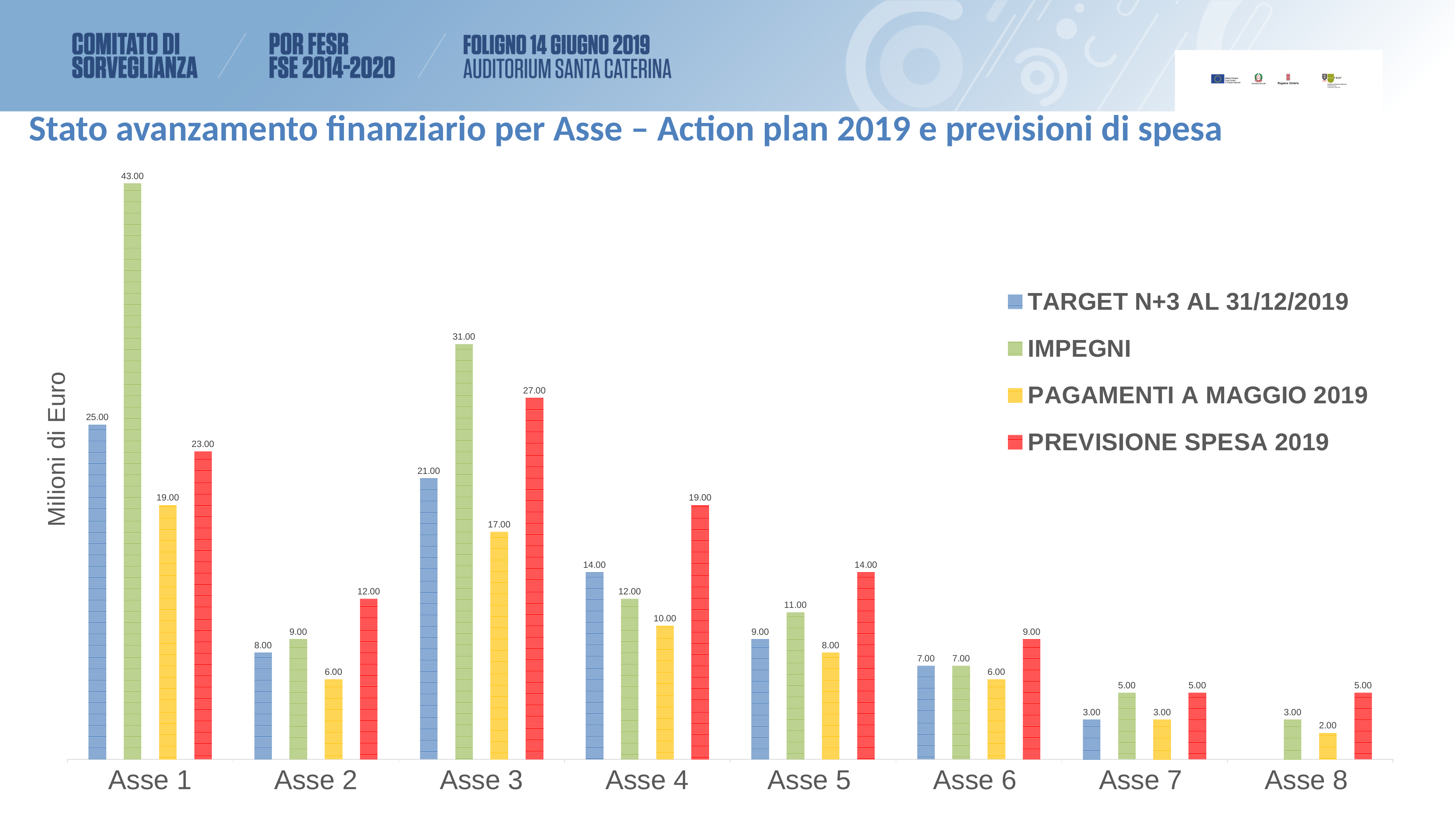
For Asse 4, which is larger: TARGET N+3 AL 31/12/2019 or IMPEGNI? TARGET N+3 AL 31/12/2019 Which Asse has the highest IMPEGNI value? Asse 1 What is the PREVISIONE SPESA 2019 value for Asse 3? 27.00 What is the label of the vertical axis? Milioni di Euro What is the difference between the IMPEGNI and TARGET N+3 AL 31/12/2019 values for Asse 3? 10.00 Which Asse has the lowest PAGAMENTI A MAGGIO 2019 value? Asse 8 How many Asse categories are shown on the x axis? 8 What is the PAGAMENTI A MAGGIO 2019 value for Asse 4? 10.00 What is the TARGET N+3 AL 31/12/2019 value for Asse 5? 9.00 How many series does the legend list? 4 What is the IMPEGNI value for Asse 1? 43.00 What kind of chart is shown on the slide? Bar chart